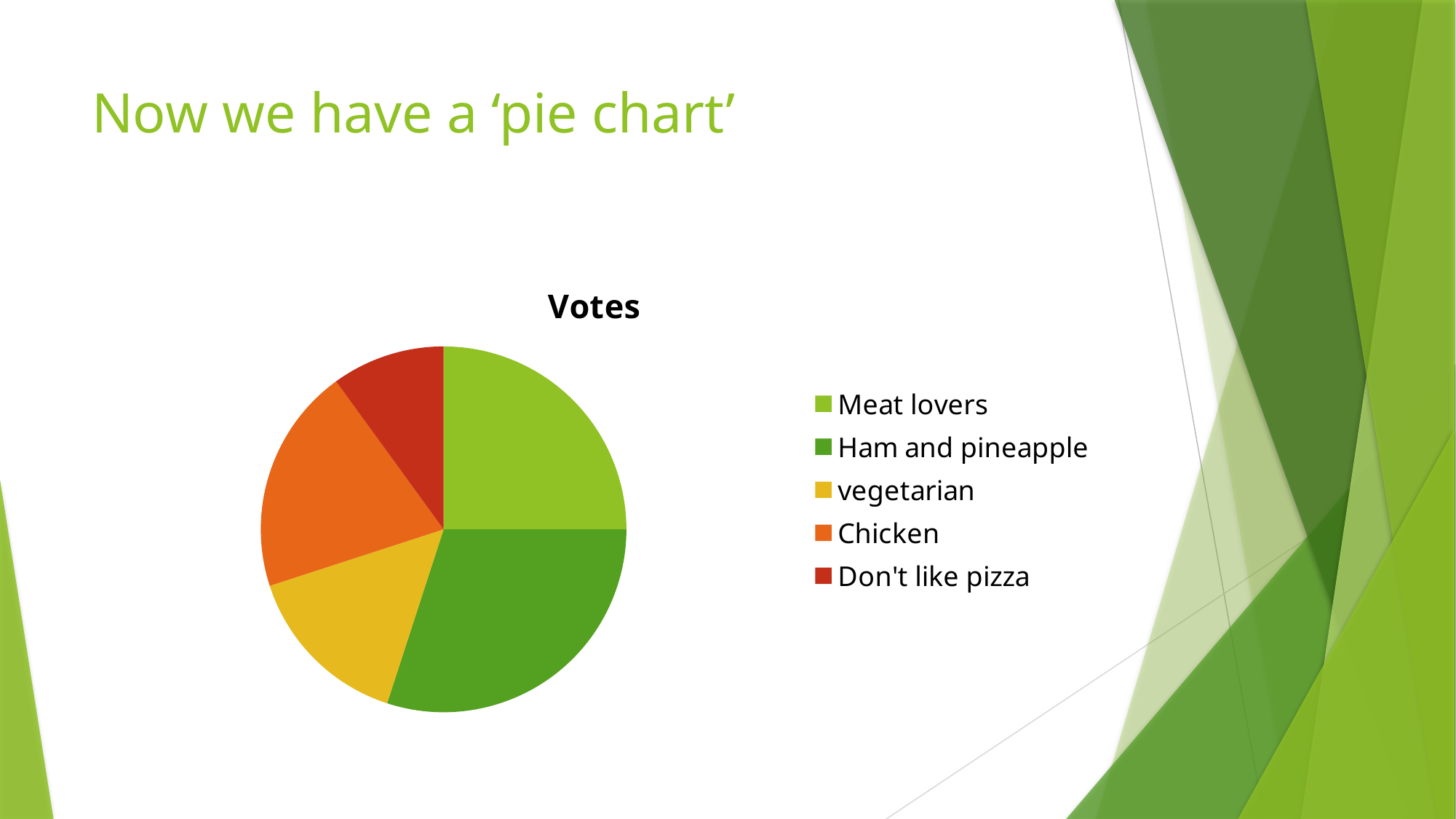
How many categories (slices) does the pie chart have? 5 Which slice is larger, Ham and pineapple or Chicken? Ham and pineapple Which category has the smallest slice of the pie? Don't like pizza What colour is the slice for Don't like pizza? red Which category has the largest slice of the pie? Ham and pineapple What kind of chart is shown on the slide? pie chart Which slice is larger, Chicken or vegetarian? Chicken Which slice is larger, Meat lovers or Don't like pizza? Meat lovers What is the title of the chart? Votes